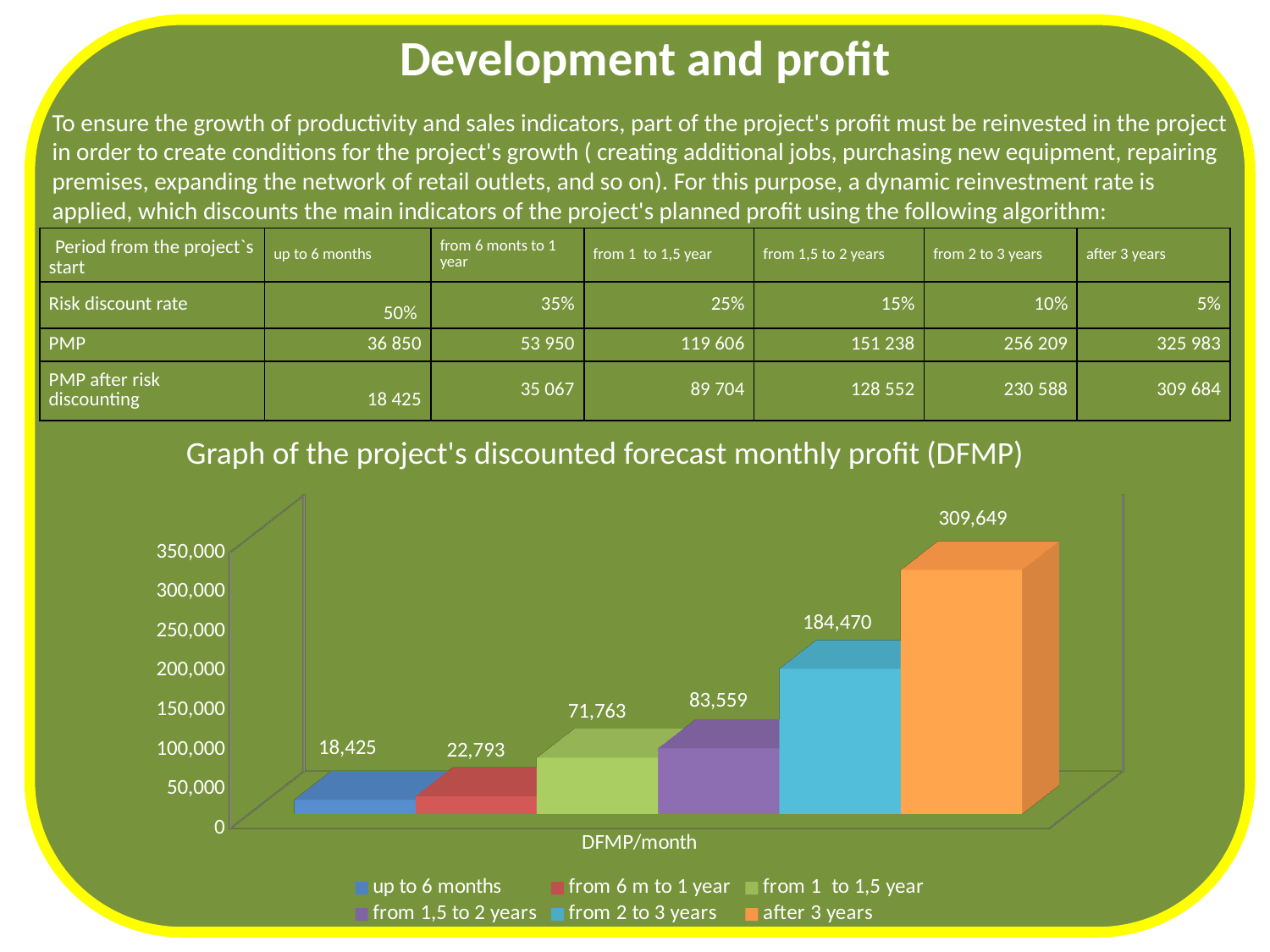
Which series has the highest value in the DFMP chart? after 3 years What is the value for 'from 1,5 to 2 years' in the DFMP chart? 83,559 How many series does the legend of the DFMP chart list? 6 What kind of chart is shown on the slide? bar chart Which is larger in the DFMP chart: 'from 1 to 1,5 year' or 'from 6 m to 1 year'? from 1 to 1,5 year Which series has the lowest value in the DFMP chart? up to 6 months What is the value for 'up to 6 months' in the DFMP chart? 18,425 What is the title of the chart on the slide? Graph of the project's discounted forecast monthly profit (DFMP) What is the difference between the 'after 3 years' and 'from 2 to 3 years' values in the DFMP chart? 125,179 Is the value for 'from 2 to 3 years' in the DFMP chart greater or less than 150,000? greater What is the value for 'after 3 years' in the DFMP chart? 309,649 What is the value for 'from 2 to 3 years' in the DFMP chart? 184,470